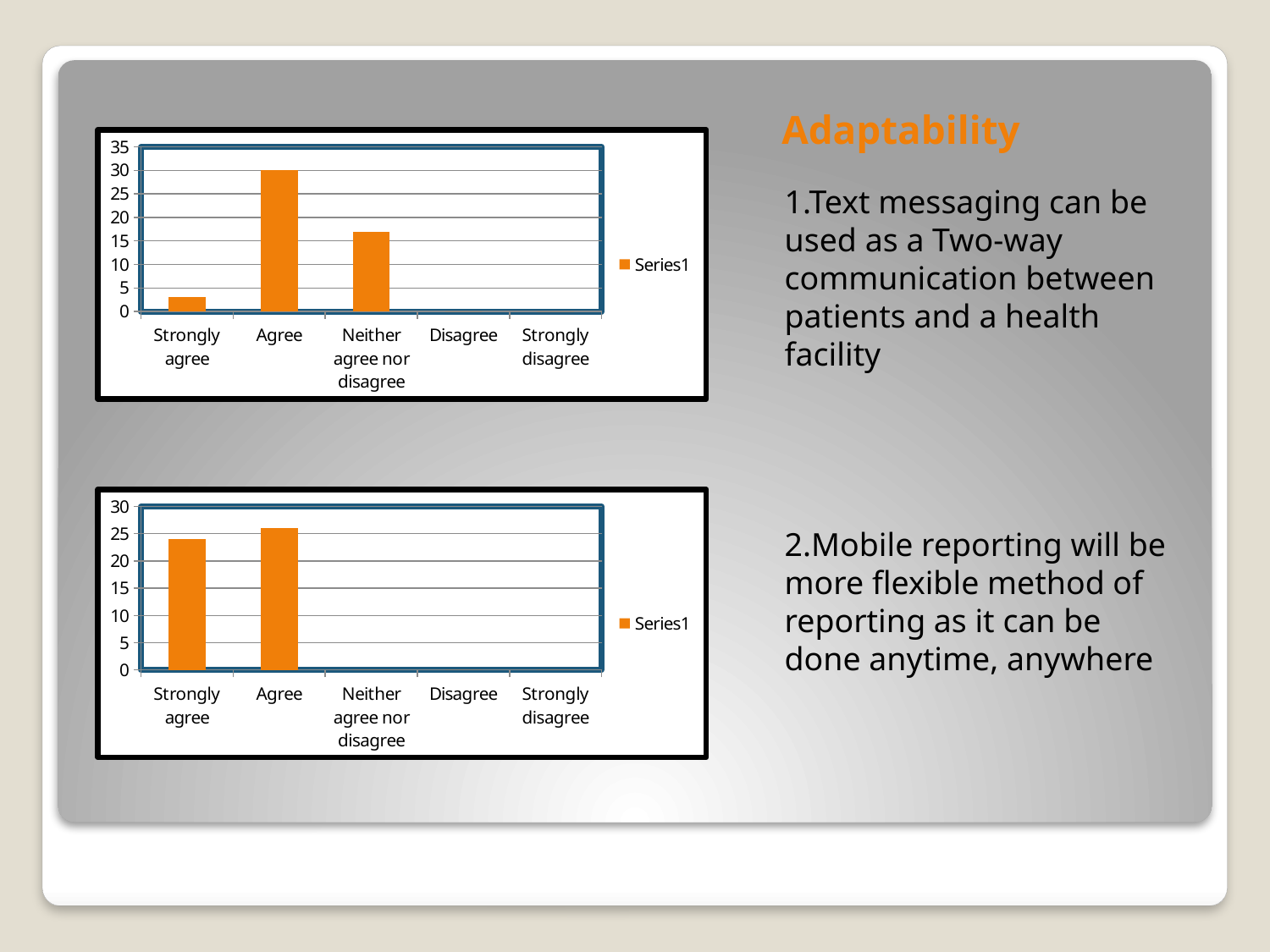
How many series does the legend of the top chart list? 1 What is the legend entry shown in the bottom chart? Series1 In the top chart, which is larger: the value for Neither agree nor disagree or the value for Strongly agree? Neither agree nor disagree How many categories are shown on the x axis of the top chart? 5 In the top chart, is the value for Strongly agree greater or less than 5? less In the bottom chart, is the value for Strongly agree greater or less than 20? greater In the top chart, what is the value for Agree? 30 In the bottom chart, which is larger: the value for Agree or the value for Strongly agree? Agree In the top chart, which category has the highest value? Agree What kind of chart is the top chart? bar chart In the top chart, is the value for Neither agree nor disagree greater or less than 15? greater